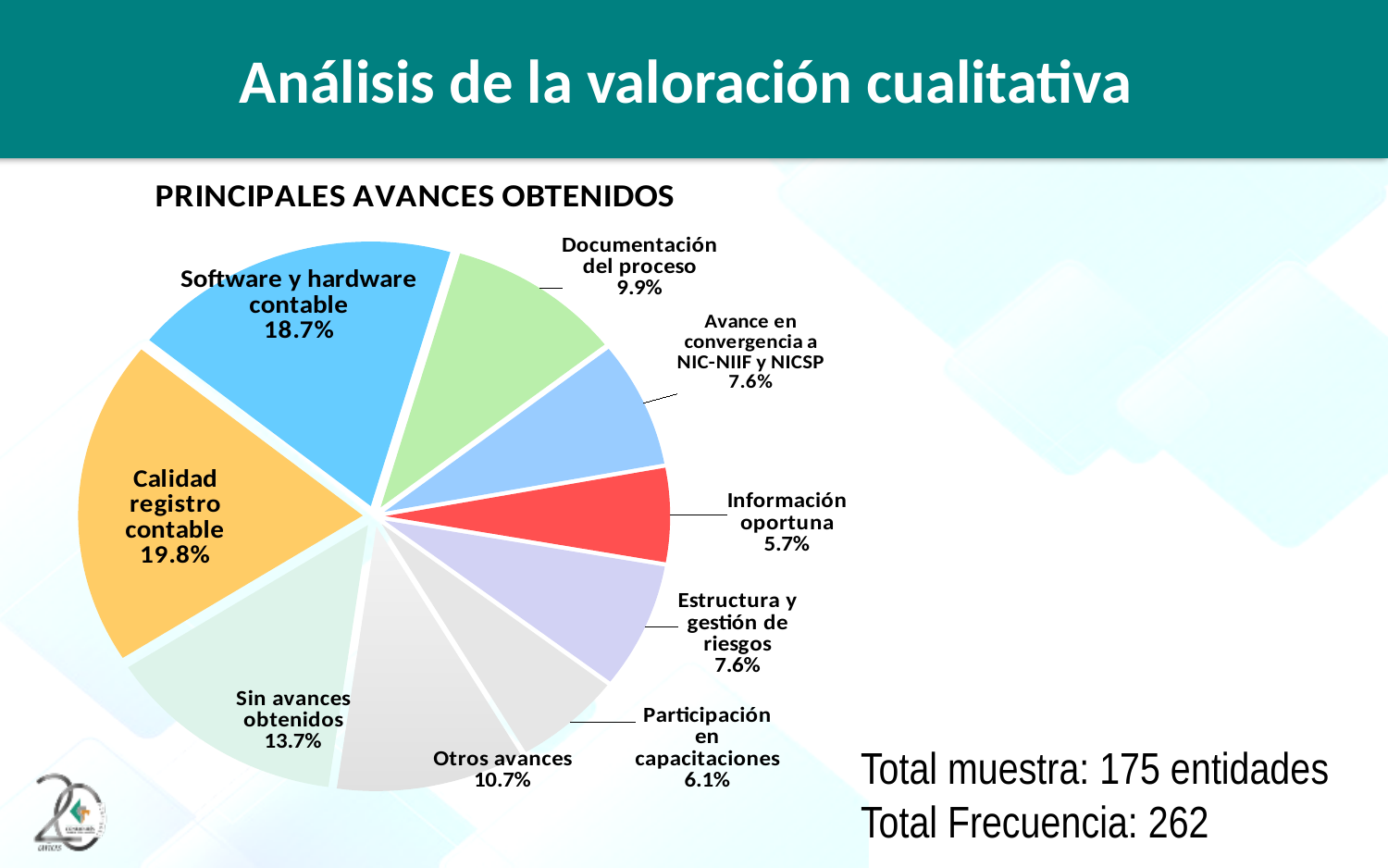
What is the title of the chart? PRINCIPALES AVANCES OBTENIDOS What percentage is shown for 'Sin avances obtenidos'? 13.7% Which category has the smallest share of the pie? Información oportuna Which category has the largest share of the pie? Calidad registro contable Which two categories both have a share of 7.6%? Avance en convergencia a NIC-NIIF y NICSP and Estructura y gestión de riesgos How many slices does the pie chart have? 9 What percentage is shown for 'Participación en capacitaciones'? 6.1% What kind of chart is shown on the slide? Pie chart What share of the pie is 'Calidad registro contable'? 19.8% What percentage is shown for 'Software y hardware contable'? 18.7% What is the difference in percentage points between 'Calidad registro contable' and 'Software y hardware contable'? 1.1 Which is larger: 'Documentación del proceso' or 'Otros avances'? Documentación del proceso